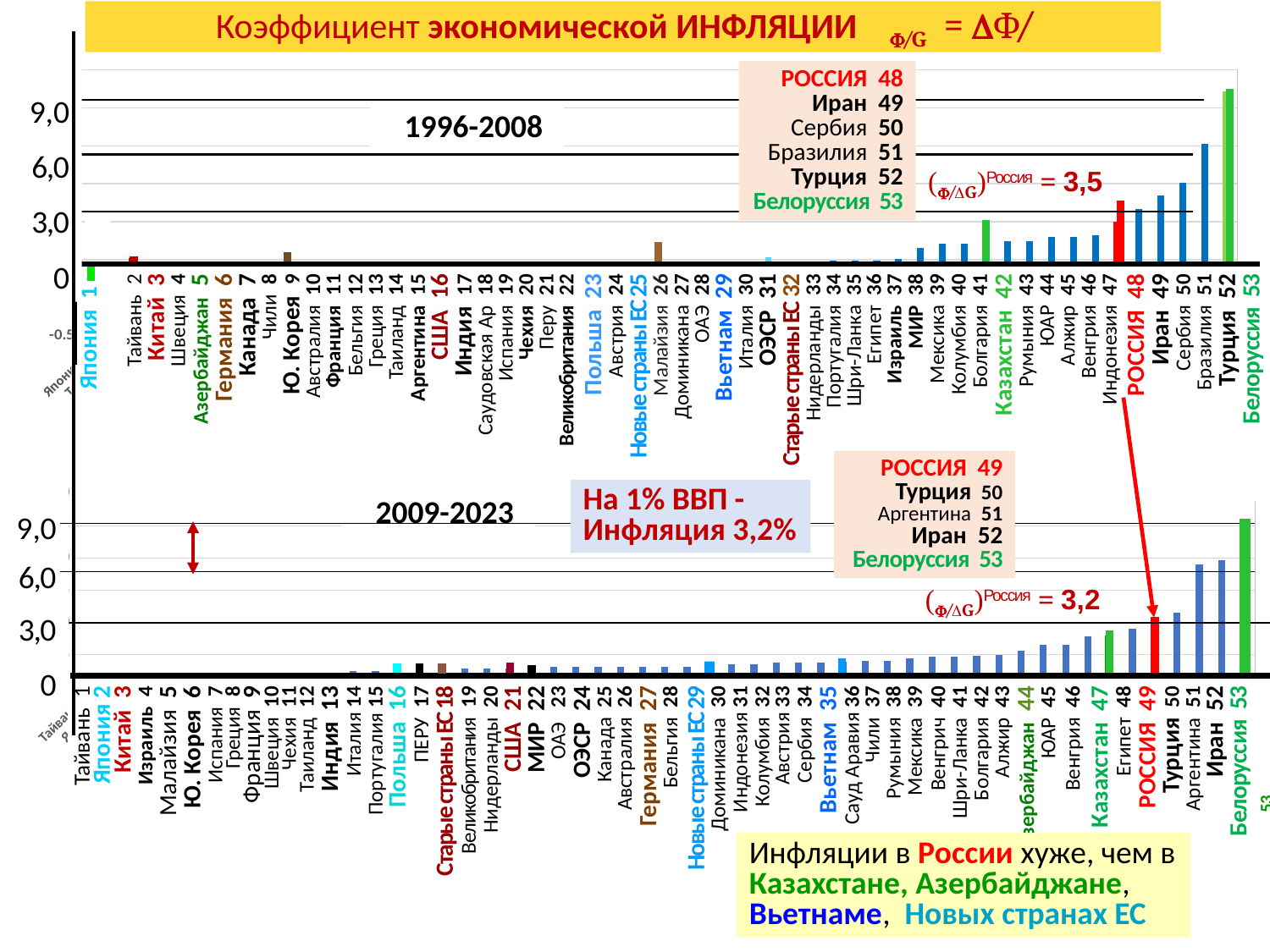
What kind of chart is the 1996-2008 chart? bar chart On the 1996-2008 chart, which country has the lowest bar? Япония On the 1996-2008 chart, is the value for Турция greater or less than 6,0? greater On the 2009-2023 chart, is the value for Иран greater or less than 6,0? greater On the 2009-2023 chart, is the value for Турция greater or less than 3,0? greater On the 1996-2008 chart, which is larger, the value for Россия or the value for Казахстан? Россия What is the difference between Russia's printed value on the 1996-2008 chart and on the 2009-2023 chart? 0,3 How many countries/categories are plotted on the 2009-2023 chart? 53 On the 1996-2008 chart, which country has the highest bar? Белоруссия On the 2009-2023 chart, what is the value printed for Россия (Russia)? 3,2 On the 1996-2008 chart, what is the value printed for Россия (Russia)? 3,5 On the 2009-2023 chart, which country has the highest bar? Белоруссия